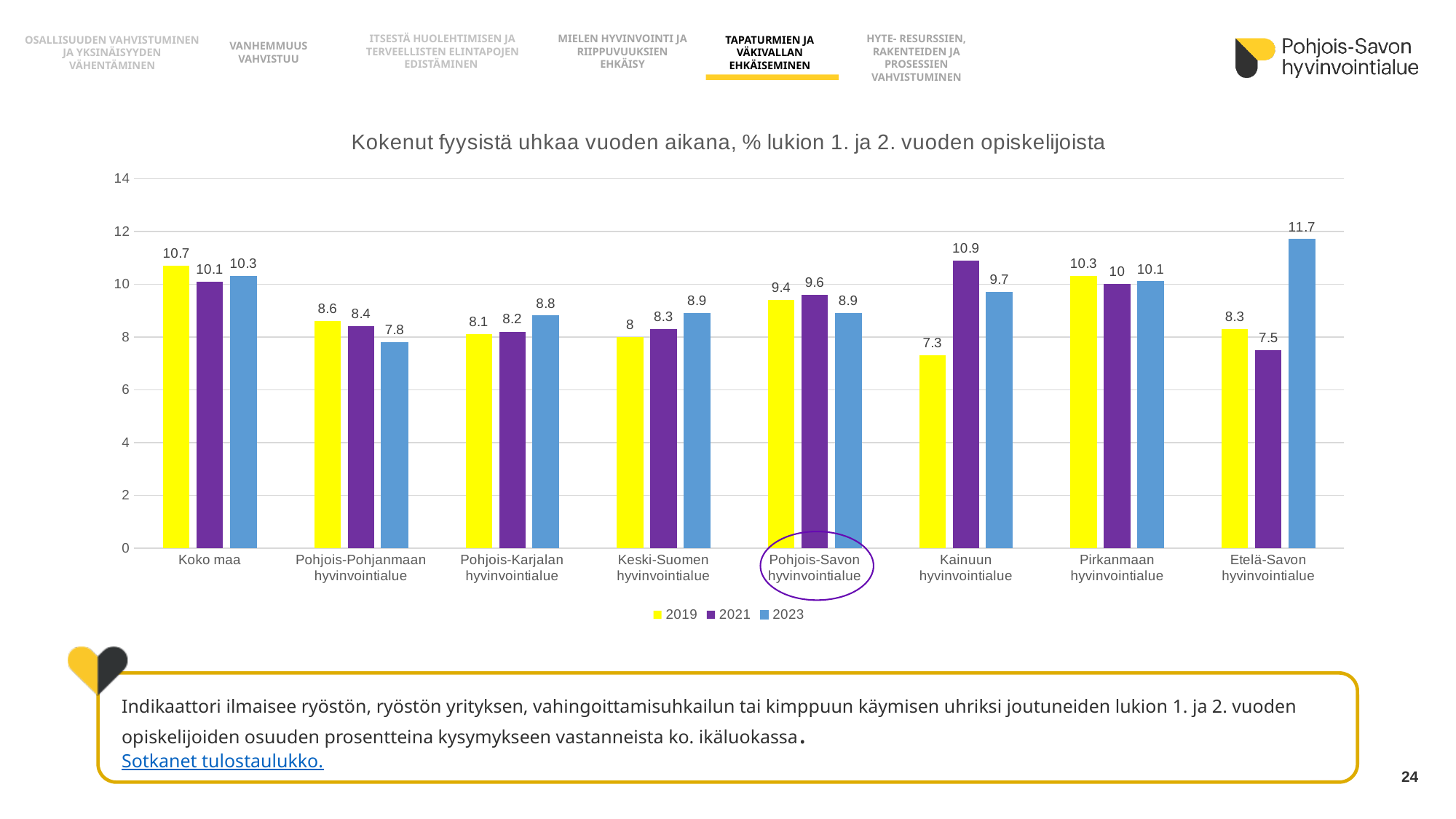
Is the 2021 value for Kainuun hyvinvointialue greater or less than 10? greater What kind of chart is shown on the slide? Bar chart Which region has the highest 2023 value? Etelä-Savon hyvinvointialue What is the difference between the 2023 and 2021 values for Etelä-Savon hyvinvointialue? 4.2 What is the 2023 value for Pohjois-Savon hyvinvointialue? 8.9 Which is larger for Pirkanmaan hyvinvointialue, the 2019 value or the 2021 value? 2019 What is the 2021 value for Koko maa? 10.1 How many regions (categories) are shown on the x axis? 8 What is the 2019 value for Kainuun hyvinvointialue? 7.3 How many series does the legend list? 3 Which region has the lowest 2019 value? Kainuun hyvinvointialue Which region's label is circled on the x axis? Pohjois-Savon hyvinvointialue